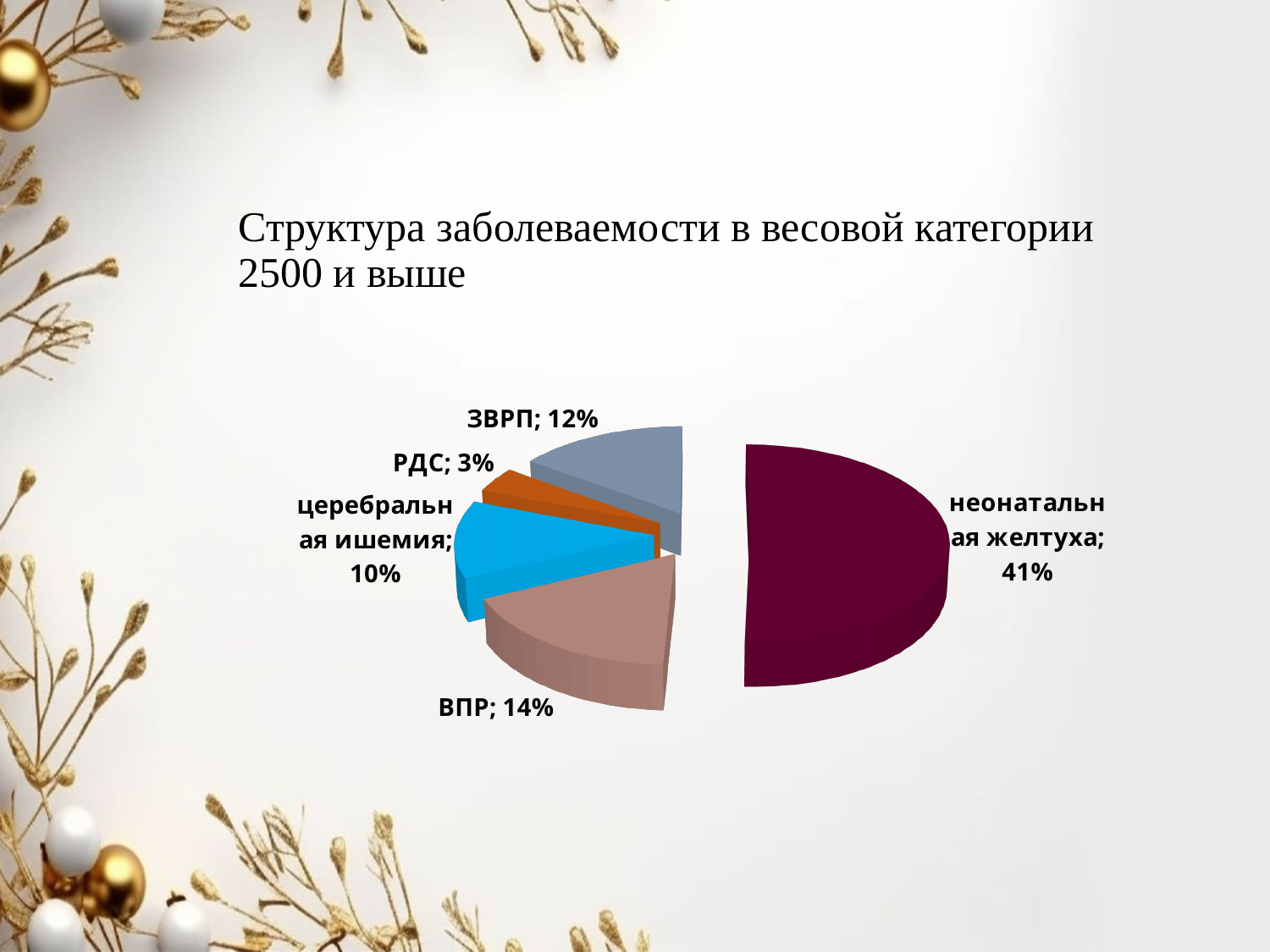
What share does неонатальная желтуха have in the pie chart? 41% Which category has the smallest slice in the pie chart? РДС What is the title of the chart on the slide? Структура заболеваемости в весовой категории 2500 и выше What share does церебральная ишемия have in the pie chart? 10% Which category has the largest slice in the pie chart? неонатальная желтуха What share does РДС have in the pie chart? 3% How many labelled slices does the pie chart have? 5 What is the difference between the shares of неонатальная желтуха and ВПР? 27% What share does ВПР have in the pie chart? 14% Which is larger, the share of ЗВРП or the share of церебральная ишемия? ЗВРП What share does ЗВРП have in the pie chart? 12% What kind of chart is shown on the slide? Pie chart